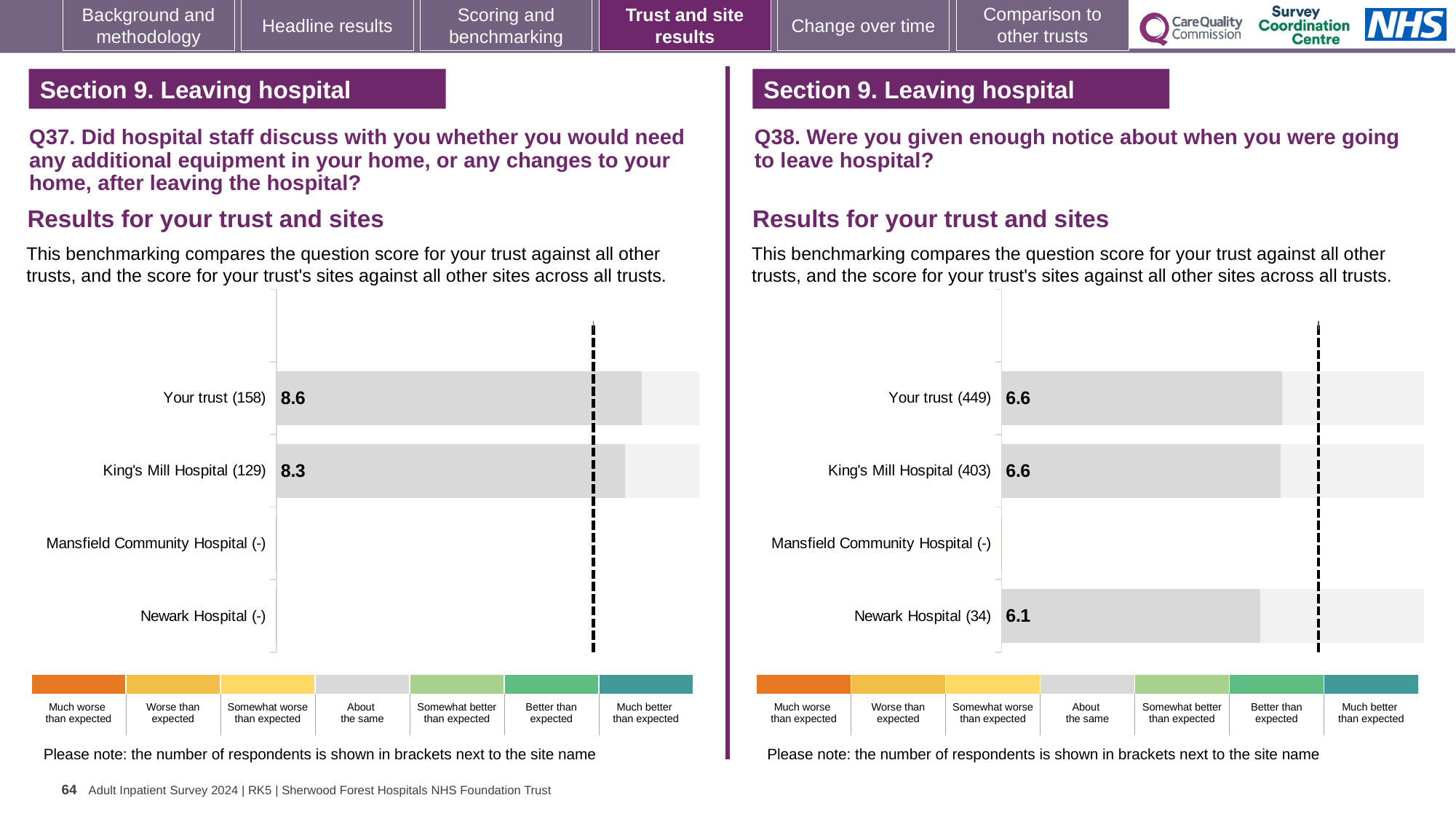
How many respondents are shown in brackets for King's Mill Hospital in the Q37 chart on the left? 129 In the Q38 chart on the right, what is the difference between the Your trust score and the Newark Hospital score? 0.5 In the Q37 chart on the left, what is the score for Your trust? 8.6 In the Q38 chart on the right, which site has the lowest score shown? Newark Hospital In the Q37 chart on the left, which is larger: the score for Your trust or the score for King's Mill Hospital? Your trust In the Q37 chart on the left, what is the difference between the Your trust score and the King's Mill Hospital score? 0.3 How many respondents are shown in brackets for Your trust in the Q38 chart on the right? 449 How many site/trust categories are listed on the y axis of the Q37 chart on the left? 4 In the Q37 chart on the left, what is the score for King's Mill Hospital? 8.3 In the Q38 chart on the right, what is the score for Newark Hospital? 6.1 In the Q38 chart on the right, what is the score for King's Mill Hospital? 6.6 What kind of chart is used for the Q38 results on the right? Bar chart